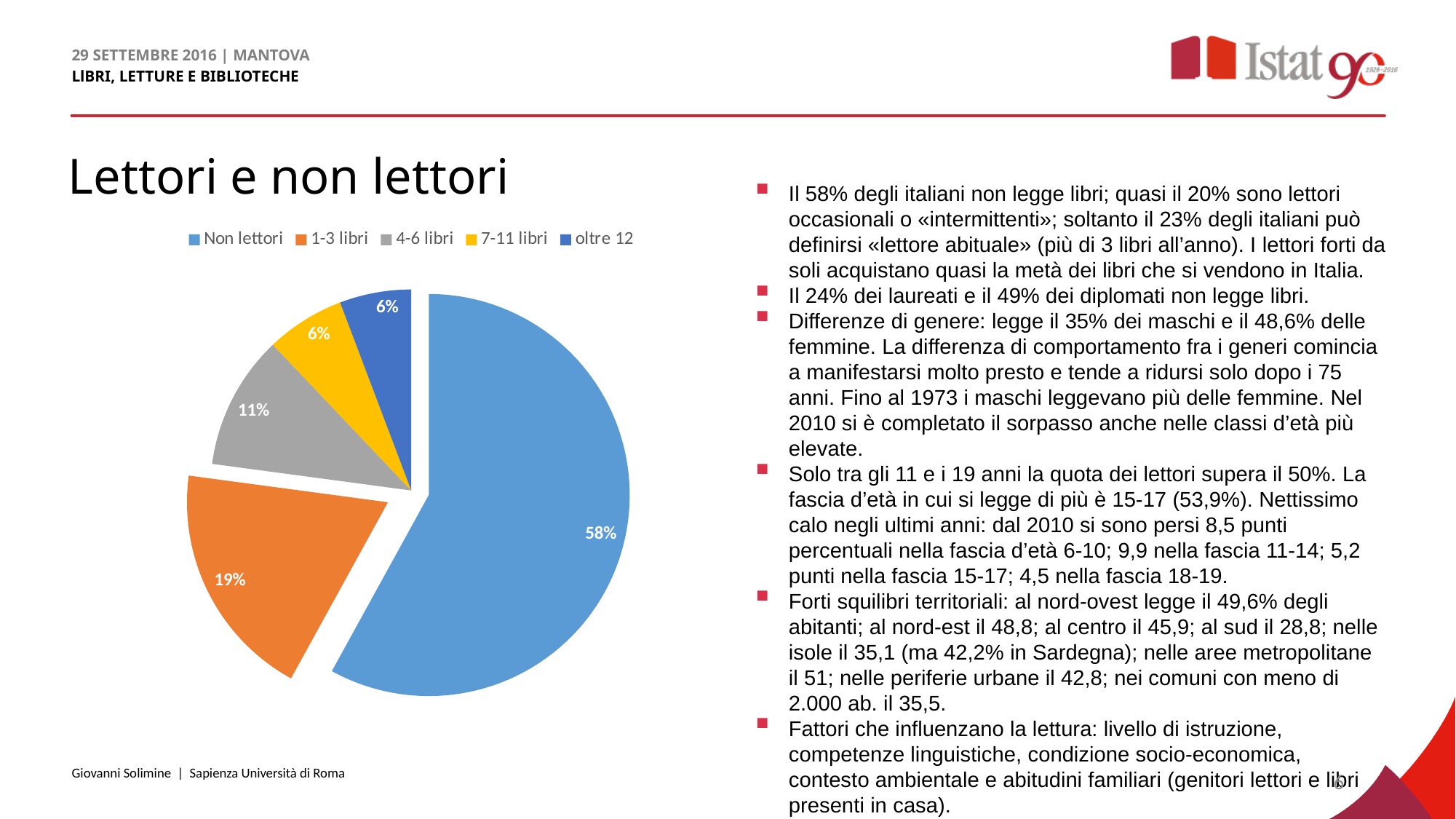
What is the value shown for the "7-11 libri" slice? 6% Which legend entry is shown in orange? 1-3 libri Which category has the largest slice of the pie? Non lettori What is the value shown for the "1-3 libri" slice? 19% What colour is the "Non lettori" slice in the pie chart? blue What is the difference in percentage points between the "Non lettori" slice and the "1-3 libri" slice? 39 What type of chart is shown on the slide? pie chart Which is larger, the "4-6 libri" slice or the "1-3 libri" slice? 1-3 libri What share of the pie does the "Non lettori" slice represent? 58% What is the value shown for the "4-6 libri" slice? 11% What is the value shown for the "oltre 12" slice? 6% How many categories does the pie chart show? 5